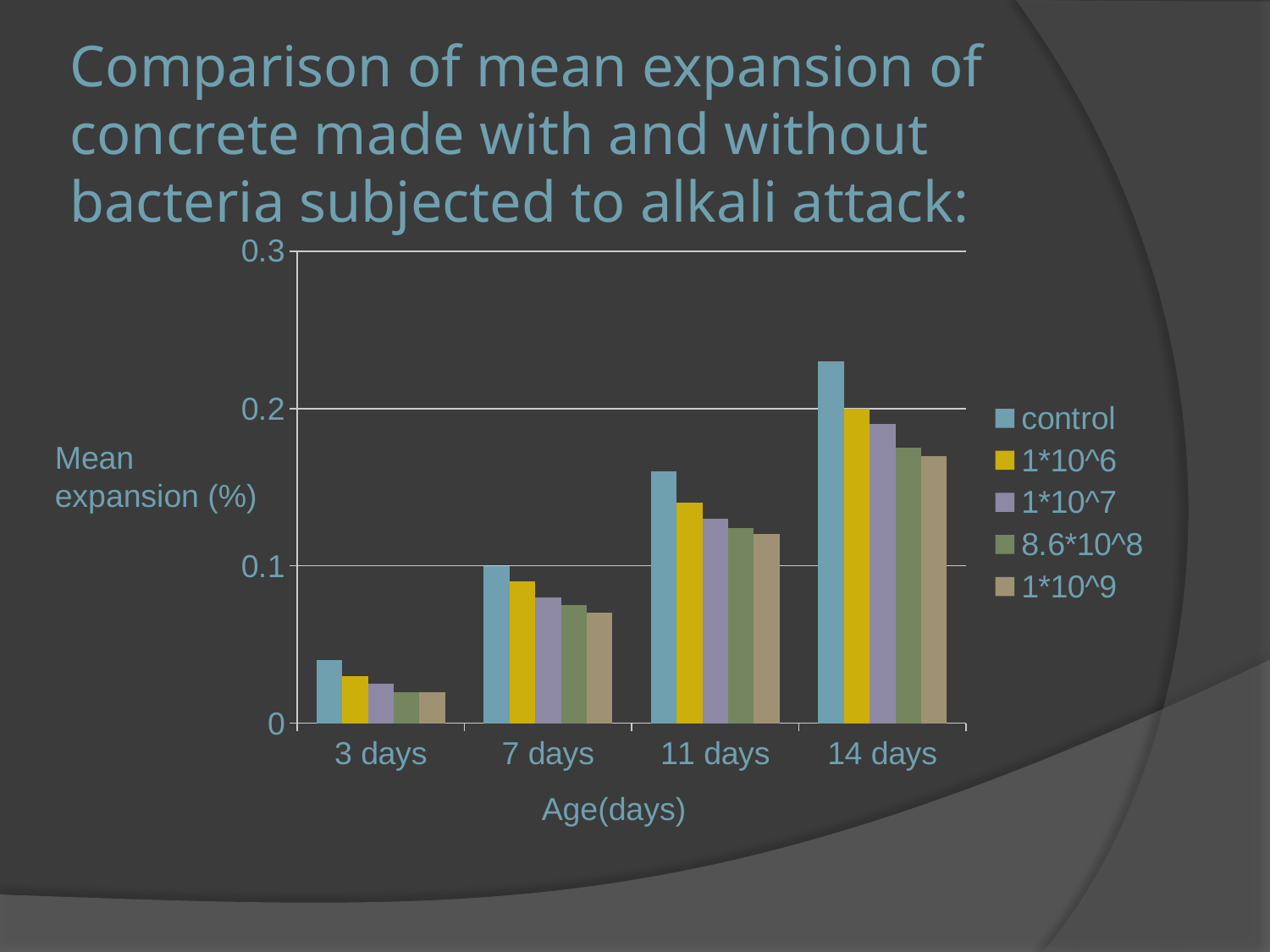
Do the control values rise or fall as age increases along the x axis? rise Is the control value at 14 days greater or less than 0.2? greater At which age is the control series highest? 14 days At 14 days, which is larger: the control value or the 1*10^9 value? control How many age categories are shown on the x axis? 4 Is the 1*10^9 value at 11 days greater or less than 0.1? greater What is the label on the vertical axis? Mean expansion (%) What is the label on the horizontal axis? Age(days) Is the 1*10^7 value at 7 days greater or less than 0.1? less At which age is the control series lowest? 3 days How many series does the legend list? 5 What kind of chart is shown on the slide? bar chart